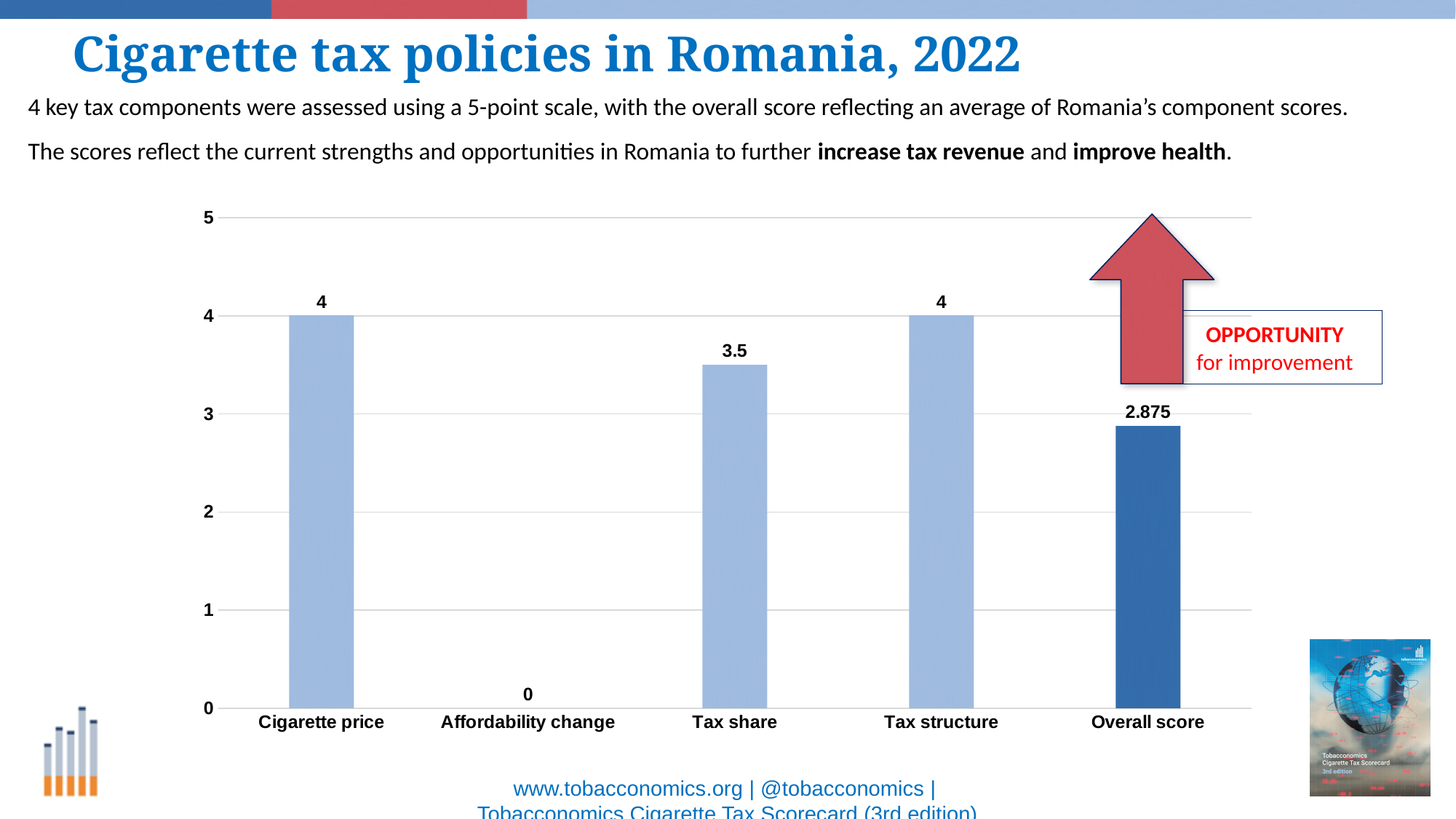
Is the value for Overall score greater or less than 3? less What is the value for Tax share? 3.5 What is the difference between the values for Cigarette price and Overall score? 1.125 What is the value for Overall score? 2.875 What is the maximum value shown on the y axis? 5 How many categories are shown on the x axis? 5 What kind of chart is shown on the slide? bar chart What is the difference between the values for Tax structure and Tax share? 0.5 Which is larger, the value for Tax share or the value for Overall score? Tax share What is the value for Affordability change? 0 Which category has the lowest value? Affordability change What is the value for Cigarette price? 4